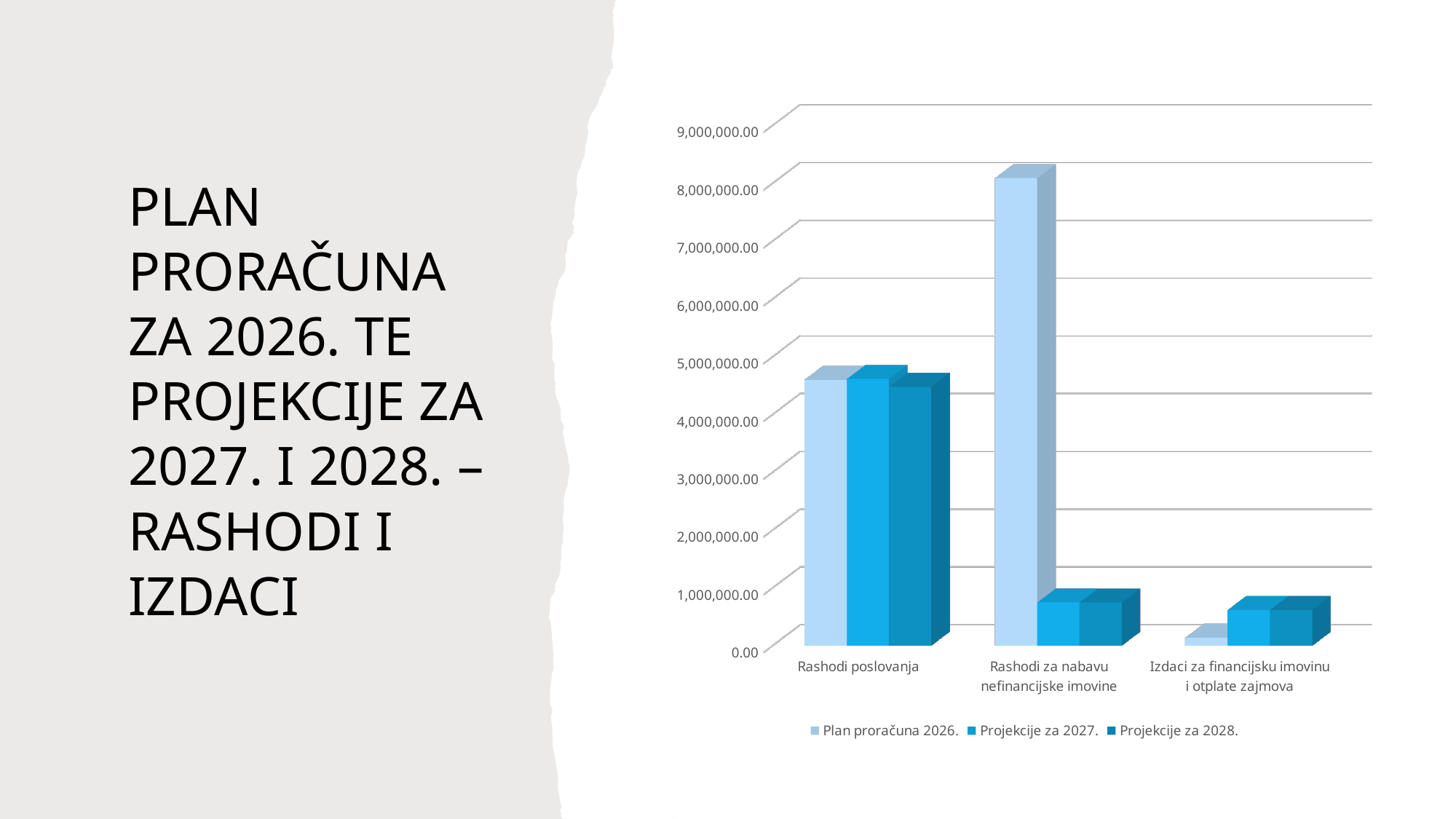
Is the Plan proračuna 2026. value for Rashodi za nabavu nefinancijske imovine greater or less than 7,000,000.00? greater For Izdaci za financijsku imovinu i otplate zajmova, which is larger: the Plan proračuna 2026. value or the Projekcije za 2027. value? Projekcije za 2027. Is the Plan proračuna 2026. value for Izdaci za financijsku imovinu i otplate zajmova greater or less than 1,000,000.00? less What are the three series listed in the chart's legend? Plan proračuna 2026., Projekcije za 2027., Projekcije za 2028. Is the Plan proračuna 2026. value for Rashodi poslovanja greater or less than 5,000,000.00? less Which category has the highest value for the Plan proračuna 2026. series? Rashodi za nabavu nefinancijske imovine How many series does the chart's legend list? 3 What kind of chart is shown on the slide? Bar chart Which category has the lowest value for the Plan proračuna 2026. series? Izdaci za financijsku imovinu i otplate zajmova For Rashodi za nabavu nefinancijske imovine, which is larger: the Plan proračuna 2026. value or the Projekcije za 2027. value? Plan proračuna 2026. How many categories are shown on the x axis of the chart? 3